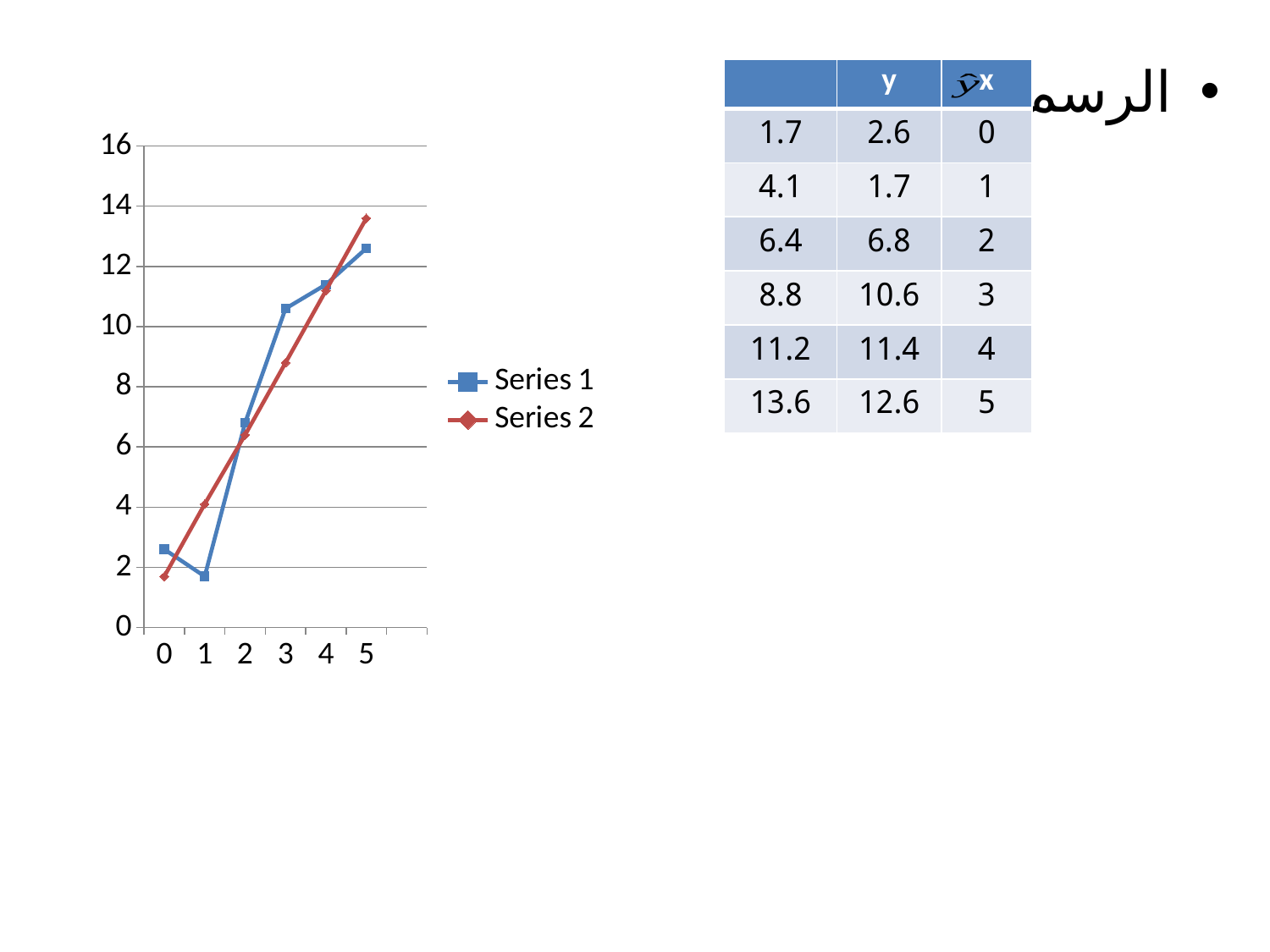
What kind of chart is shown on the slide? line chart Is the value of Series 2 at x = 5 greater or less than 12? greater At which x value does Series 1 reach its highest point? 5 Does Series 2 rise or fall as x increases from 0 to 5? rise Is the value of Series 1 at x = 1 greater or less than 2? less How many x-axis points are plotted for each series? 6 At x = 3, which series has the higher value, Series 1 or Series 2? Series 1 How many series does the chart legend list? 2 Is the value of Series 2 at x = 3 greater or less than 10? less At x = 5, which series has the higher value, Series 1 or Series 2? Series 2 At x = 1, which series has the higher value, Series 1 or Series 2? Series 2 At which x value does Series 1 reach its lowest point? 1